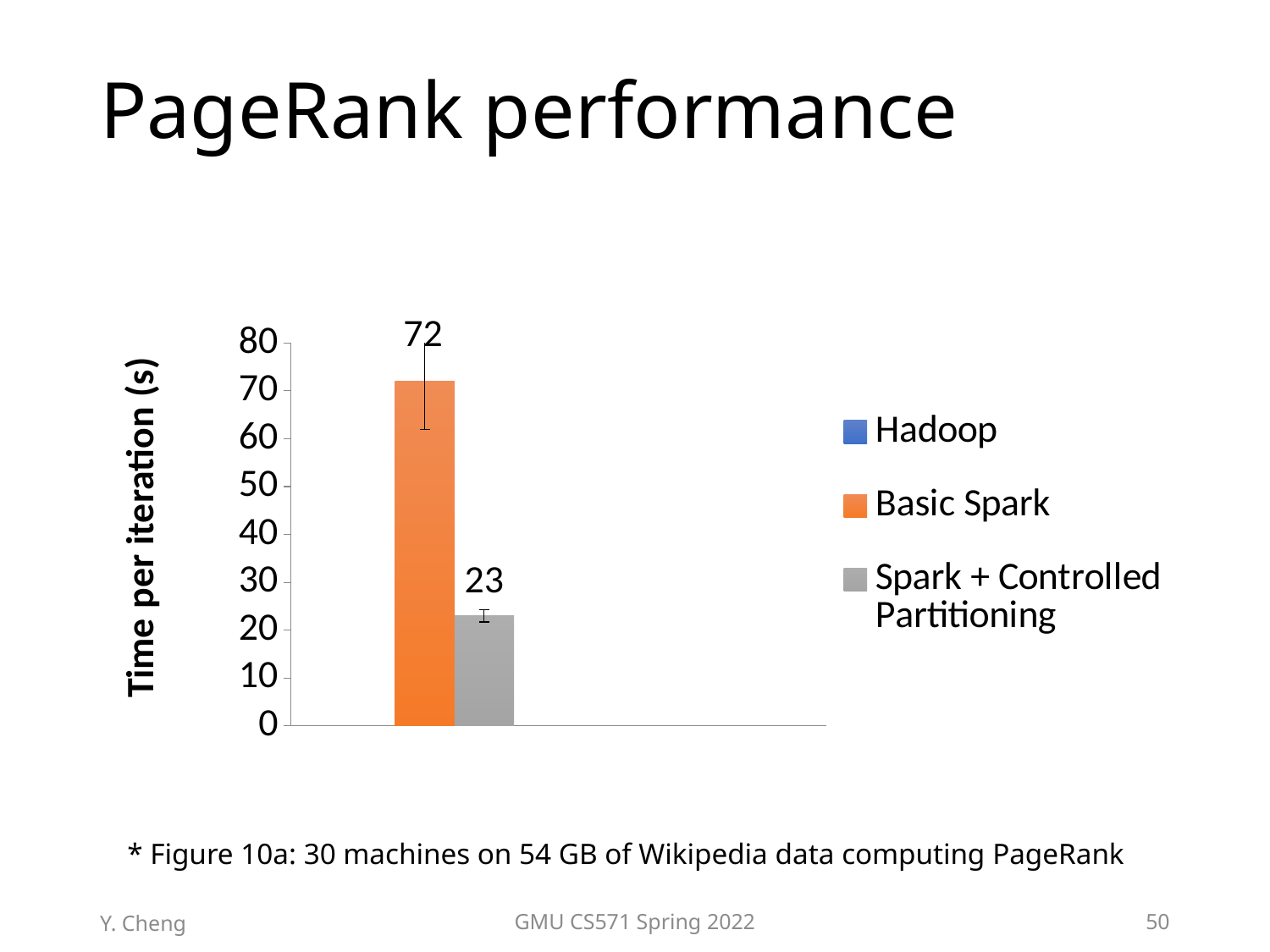
What is the time per iteration for Spark + Controlled Partitioning? 23 Which is larger, the value for Basic Spark or the value for Spark + Controlled Partitioning? Basic Spark Is the value for Basic Spark greater or less than 60? greater Which series has the tallest bar in the chart? Basic Spark What is the difference between the Basic Spark value and the Spark + Controlled Partitioning value? 49 What is the label of the vertical axis? Time per iteration (s) Which plotted series has the shortest bar in the chart? Spark + Controlled Partitioning What is the time per iteration for Basic Spark? 72 How many bars are plotted in the chart? 2 How many series does the legend list? 3 What kind of chart is shown on the slide? Bar chart Is the value for Spark + Controlled Partitioning greater or less than 30? less